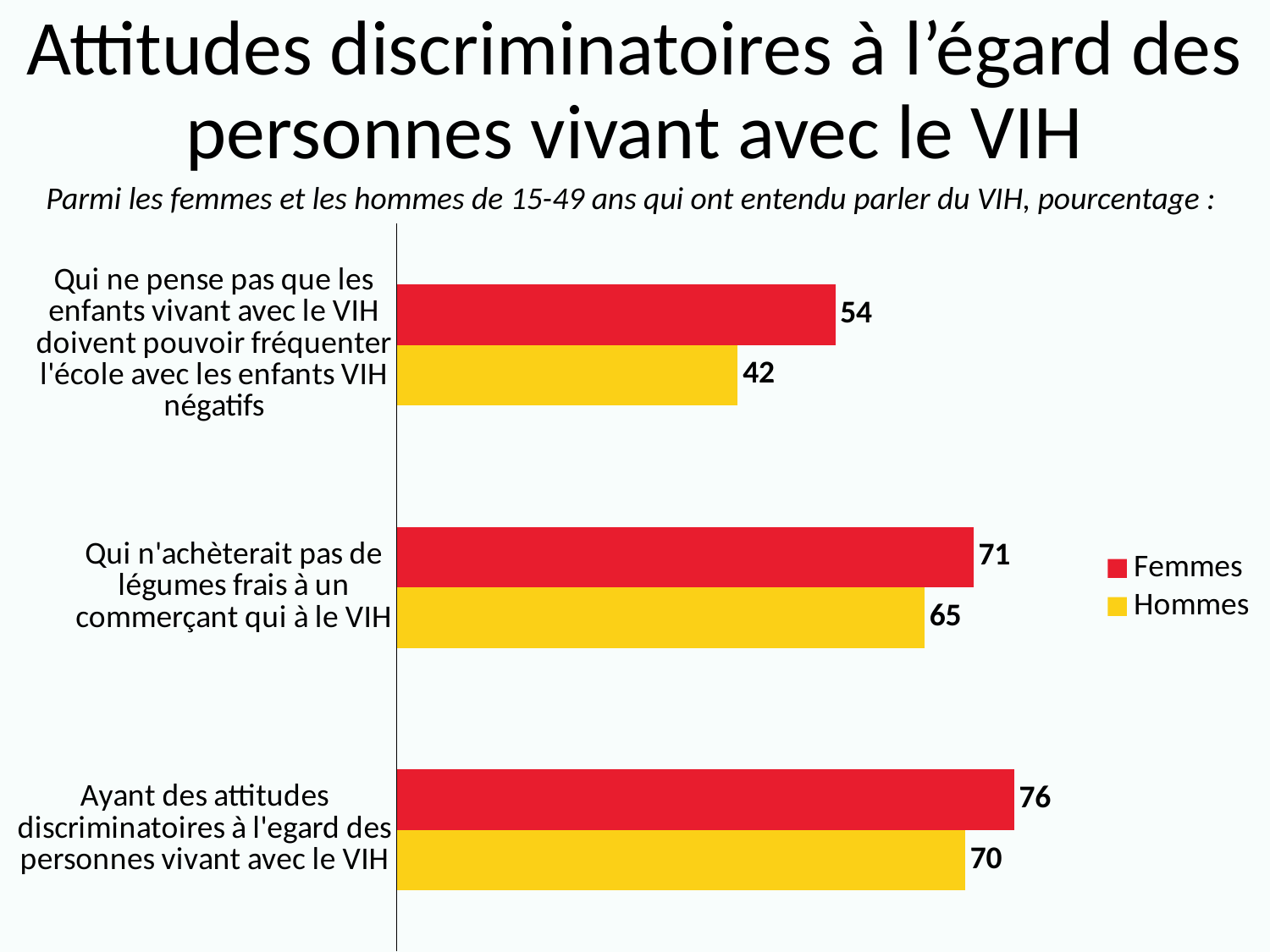
Which is larger in the category 'Qui n'achèterait pas de légumes frais à un commerçant qui à le VIH': the Femmes value or the Hommes value? Femmes Which category has the highest value for Femmes? Ayant des attitudes discriminatoires à l'egard des personnes vivant avec le VIH What is the difference between the Femmes and Hommes values in the category 'Qui ne pense pas que les enfants vivant avec le VIH doivent pouvoir fréquenter l'école avec les enfants VIH négatifs'? 12 What is the value for Femmes in the category 'Ayant des attitudes discriminatoires à l'egard des personnes vivant avec le VIH'? 76 What is the value for Femmes in the category 'Qui n'achèterait pas de légumes frais à un commerçant qui à le VIH'? 71 What kind of chart is shown on the slide? Bar chart Which category has the lowest value for Hommes? Qui ne pense pas que les enfants vivant avec le VIH doivent pouvoir fréquenter l'école avec les enfants VIH négatifs What is the value for Hommes in the category 'Qui n'achèterait pas de légumes frais à un commerçant qui à le VIH'? 65 What is the value for Hommes in the category 'Qui ne pense pas que les enfants vivant avec le VIH doivent pouvoir fréquenter l'école avec les enfants VIH négatifs'? 42 What is the difference between the Femmes and Hommes values in the category 'Ayant des attitudes discriminatoires à l'egard des personnes vivant avec le VIH'? 6 How many series does the legend list? 2 How many categories are shown in the chart? 3